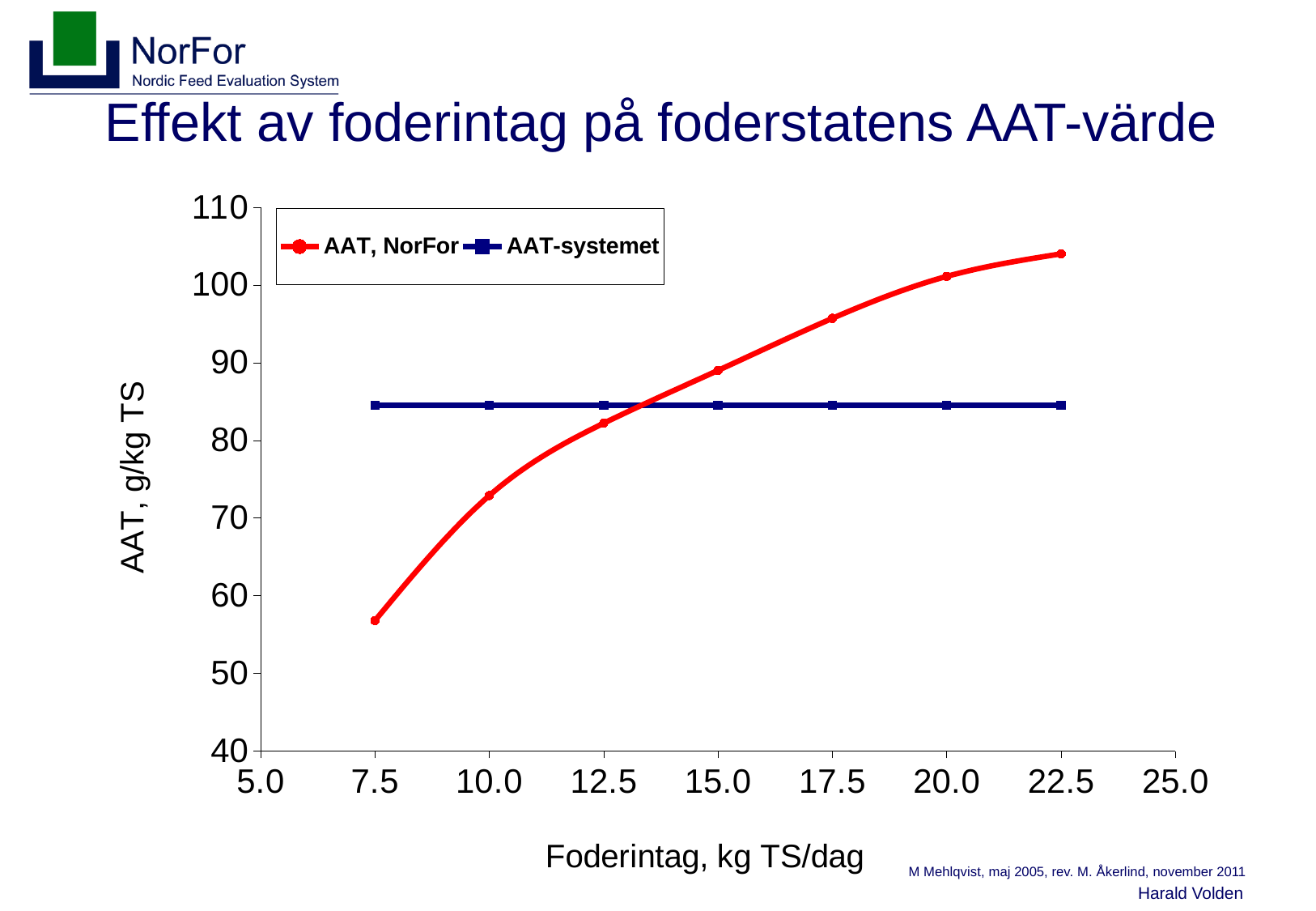
Is the AAT, NorFor value at 22.5 kg TS/dag greater or less than 100? greater At 22.5 kg TS/dag, which series has the higher AAT value, AAT, NorFor or AAT-systemet? AAT, NorFor At 7.5 kg TS/dag, which series has the higher AAT value, AAT, NorFor or AAT-systemet? AAT-systemet Is the AAT-systemet value at 15.0 kg TS/dag greater or less than 80? greater Is the AAT, NorFor value at 7.5 kg TS/dag greater or less than 60? less What is the label of the y axis? AAT, g/kg TS How many series does the legend list? 2 Does the AAT, NorFor series rise or fall as feed intake (Foderintag) increases along the x axis? rises How many data points are plotted for the AAT, NorFor series? 7 What kind of chart is shown on the slide? line chart What is the title of the chart on the slide? Effekt av foderintag på foderstatens AAT-värde